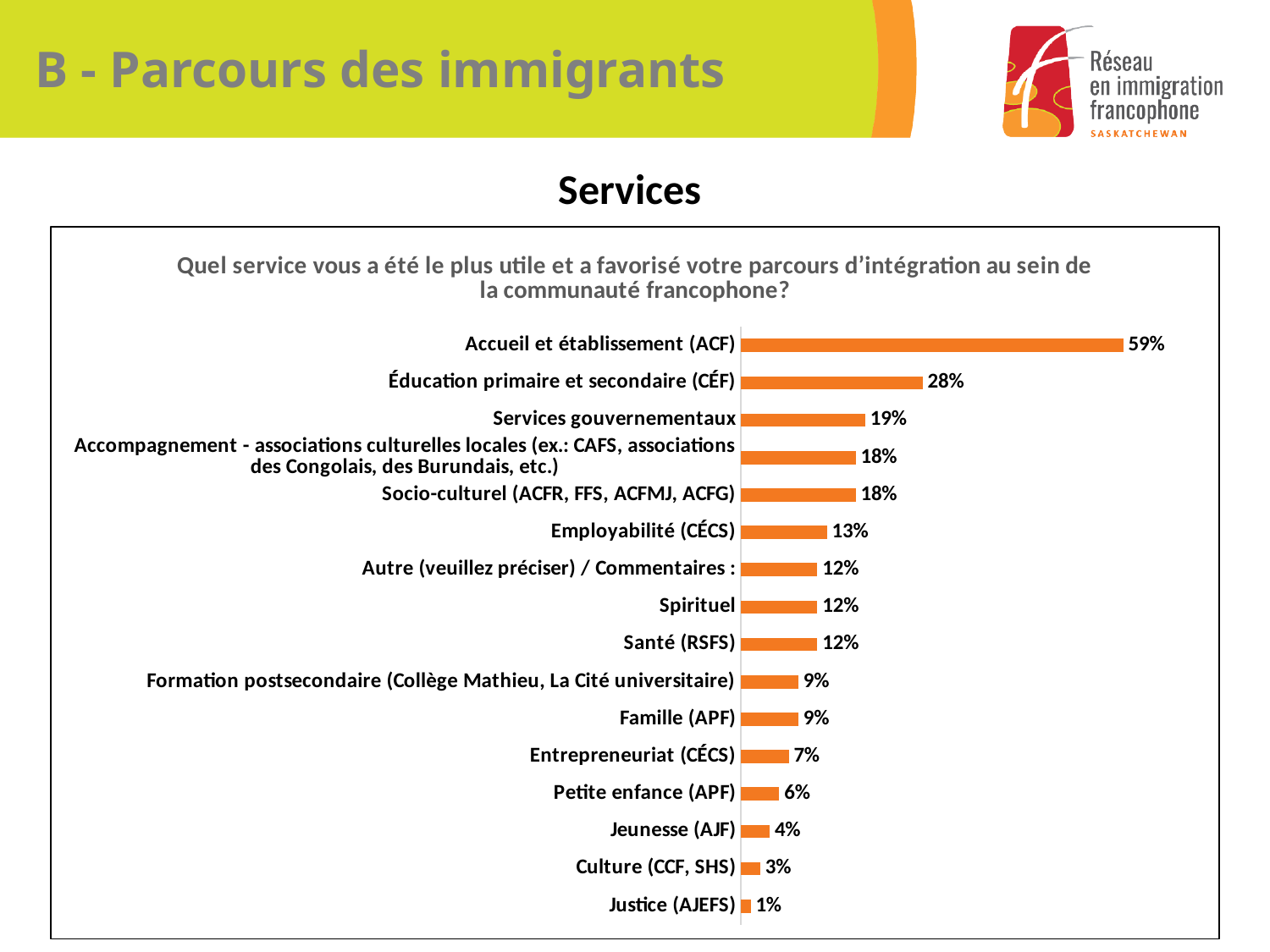
How many categories are shown in the chart? 16 Which category has the highest value? Accueil et établissement (ACF) What is the difference between the values for Accueil et établissement (ACF) and Éducation primaire et secondaire (CÉF)? 31% What kind of chart is shown on the slide? Bar chart Which category has the lowest value? Justice (AJEFS) What is the difference between the values for Services gouvernementaux and Employabilité (CÉCS)? 6% Which is larger, the value for Famille (APF) or the value for Entrepreneuriat (CÉCS)? Famille (APF) What is the value for Justice (AJEFS)? 1% What is the value for Santé (RSFS)? 12% What is the value for Accueil et établissement (ACF)? 59% What is the value for Éducation primaire et secondaire (CÉF)? 28% What is the title of the chart? Quel service vous a été le plus utile et a favorisé votre parcours d'intégration au sein de la communauté francophone?